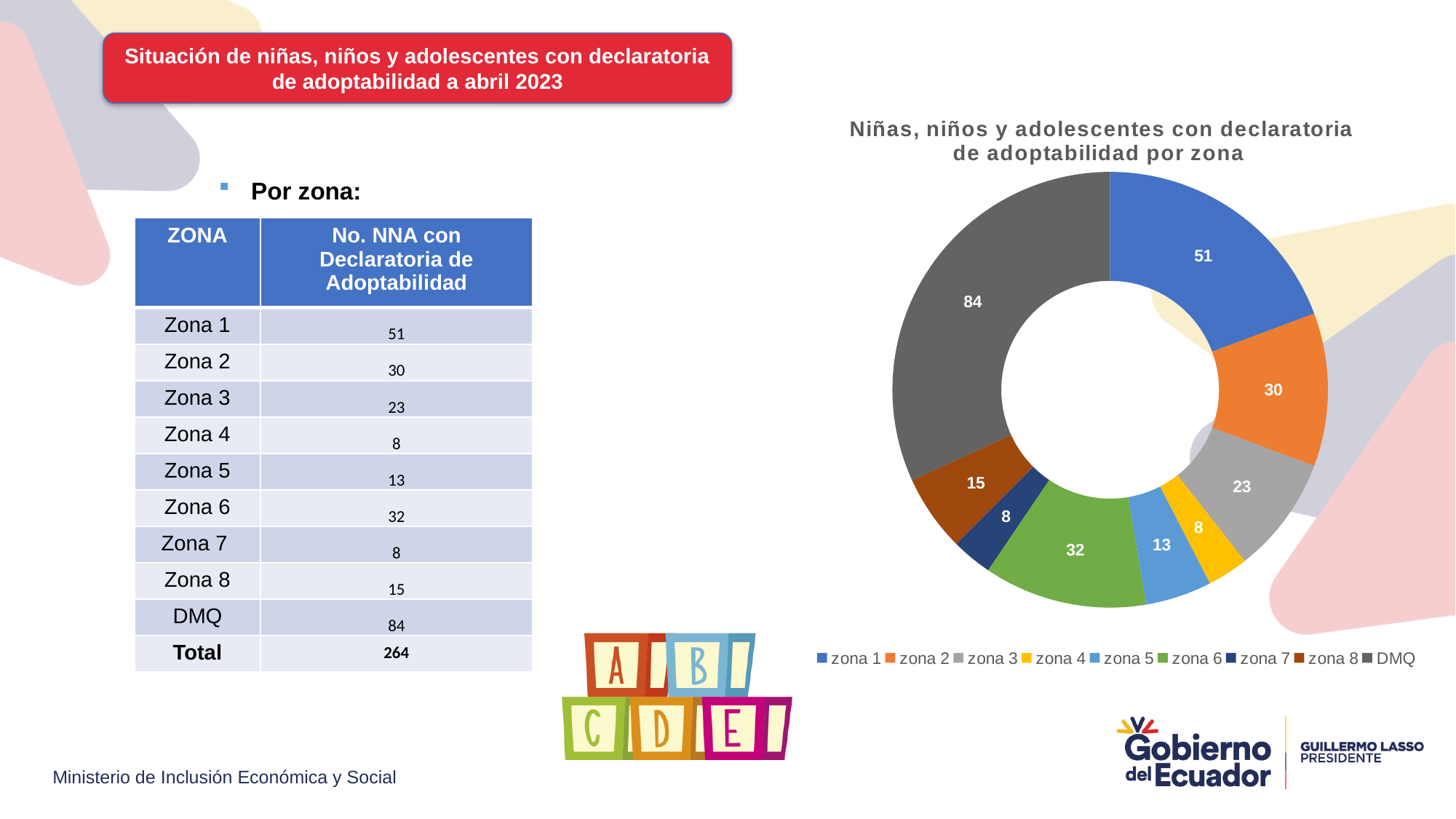
How many entries does the legend list? 9 What is the value for DMQ in the chart? 84 What is the value for zona 5 in the chart? 13 What is the difference between the values for zona 6 and zona 2? 2 How many slices does the chart have? 9 What is the title of the chart? Niñas, niños y adolescentes con declaratoria de adoptabilidad por zona What is the value for zona 6 in the chart? 32 What type of chart is shown on the slide? doughnut chart Which is larger, the value for zona 2 or the value for zona 3? zona 2 What is the difference between the values for DMQ and zona 1? 33 Which zone has the largest slice in the chart? DMQ Which zones share the smallest value in the chart? zona 4 and zona 7